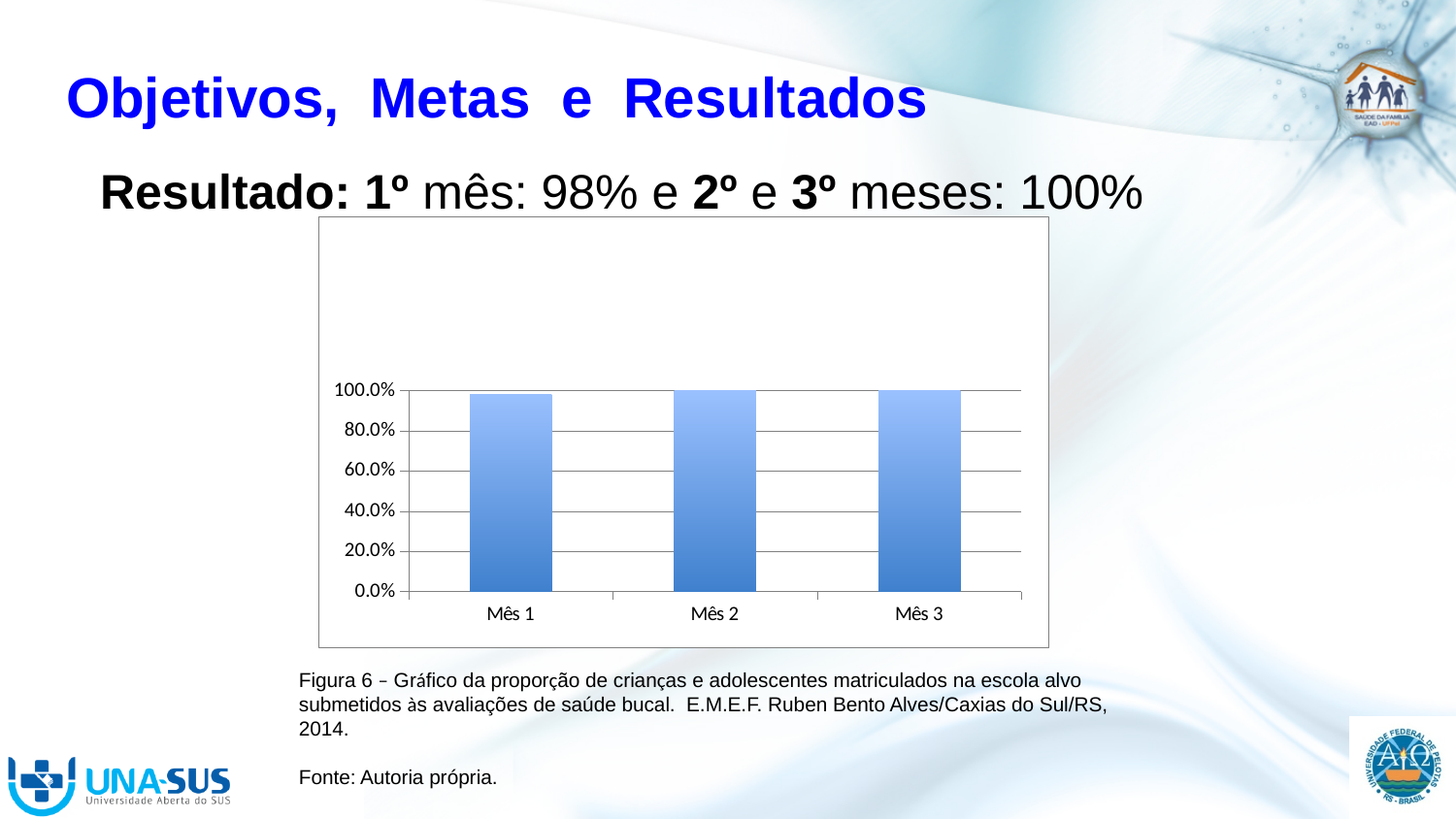
What is the value for Mês 2 in the chart? 100.0% Is the value for Mês 1 greater or less than 80.0%? greater What is the figure number given in the caption below the chart? Figura 6 Do the values rise or fall from Mês 1 to Mês 2? rise What is the highest tick value shown on the y axis of the chart? 100.0% What is the value for Mês 3 in the chart? 100.0% According to the slide, what was the result for the 1º mês? 98% Is the value for Mês 3 greater or less than 60.0%? greater Which month has the lowest value in the chart? Mês 1 What kind of chart is shown on the slide? bar chart How many categories (months) are shown on the x axis of the chart? 3